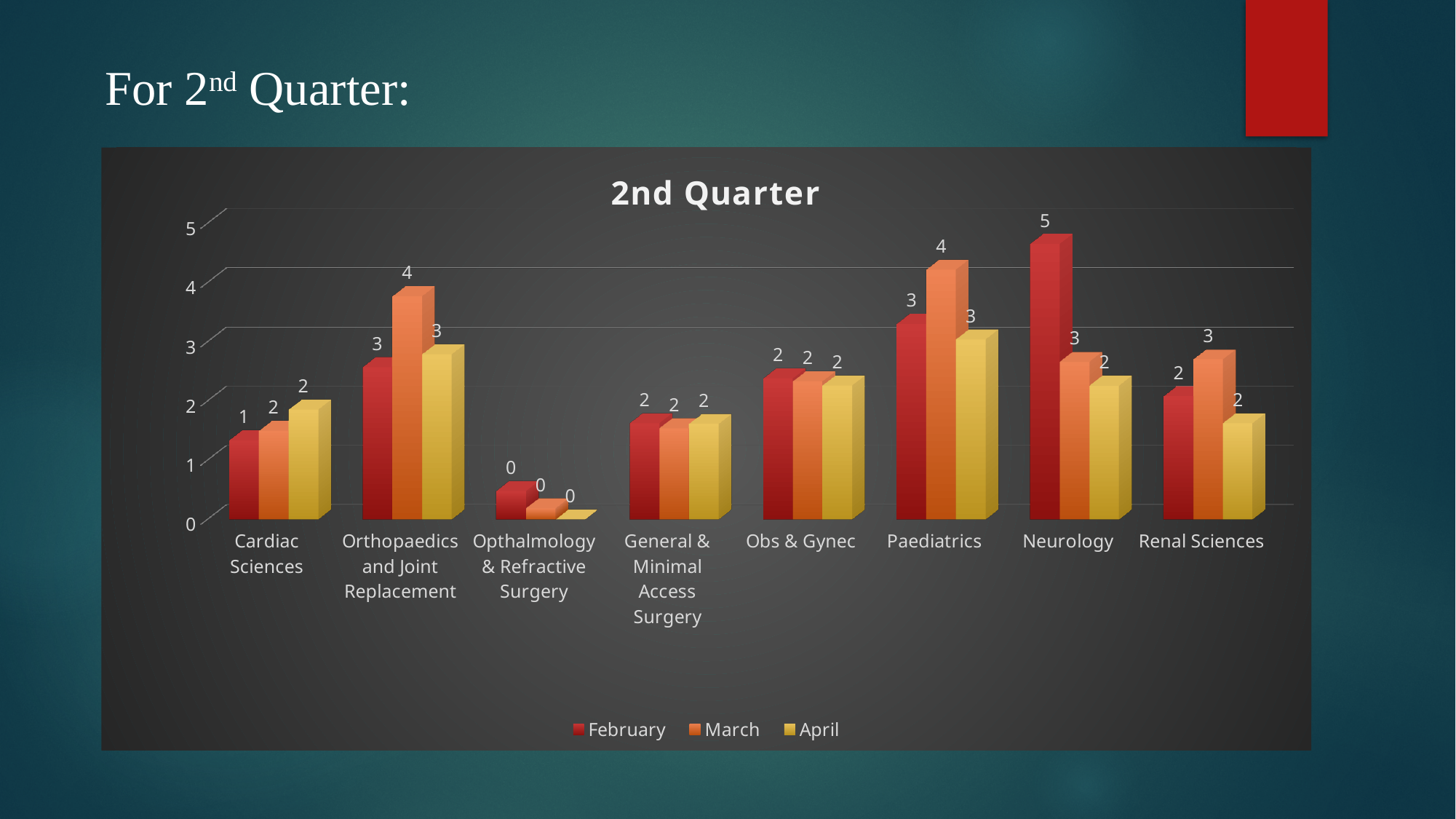
Which category has the lowest March value? Opthalmology & Refractive Surgery What is the title of the chart? 2nd Quarter What kind of chart is shown on the slide? Bar chart What is the March value for Orthopaedics and Joint Replacement? 4 What is the February value for Cardiac Sciences? 1 What is the April value for Renal Sciences? 2 Which category has the highest February value? Neurology Which is larger for Paediatrics, the February value or the March value? March How many categories are shown on the x axis? 8 What is the February value for Neurology? 5 How many series does the legend list? 3 What is the difference between the February and April values for Neurology? 3